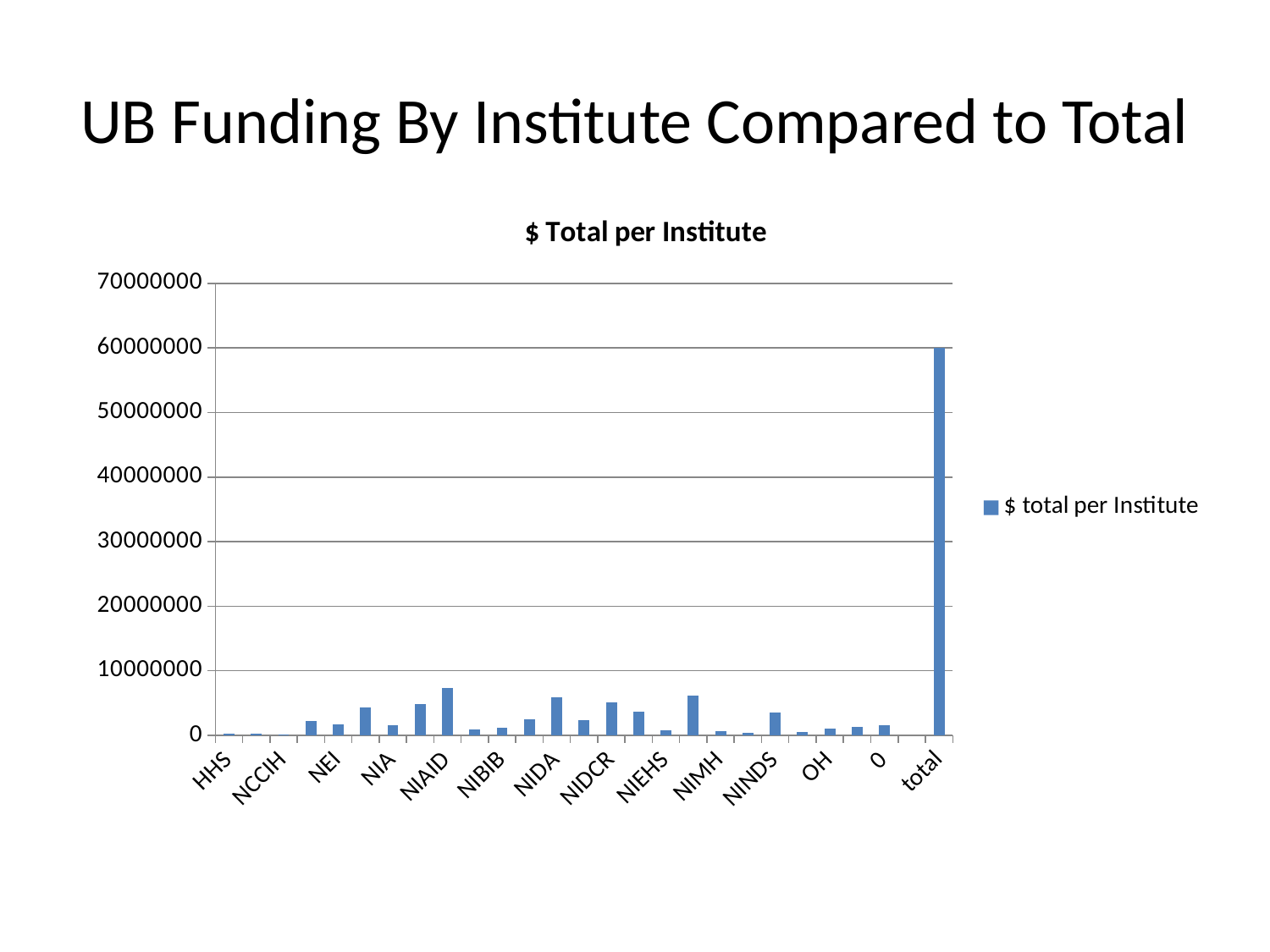
Is the value for NIAID greater or less than 10000000? less Which is larger, the value for NIEHS or the value for OH? OH Is the value for total greater or less than 70000000? less Which is larger, the value for NIAID or the value for NEI? NIAID What kind of chart is shown on the slide? bar chart What is the title of the chart? $ Total per Institute Which category has the highest value in the chart? total Is the value for total greater or less than 50000000? greater Which is larger, the value for total or the value for NIAID? total How many series does the legend list? 1